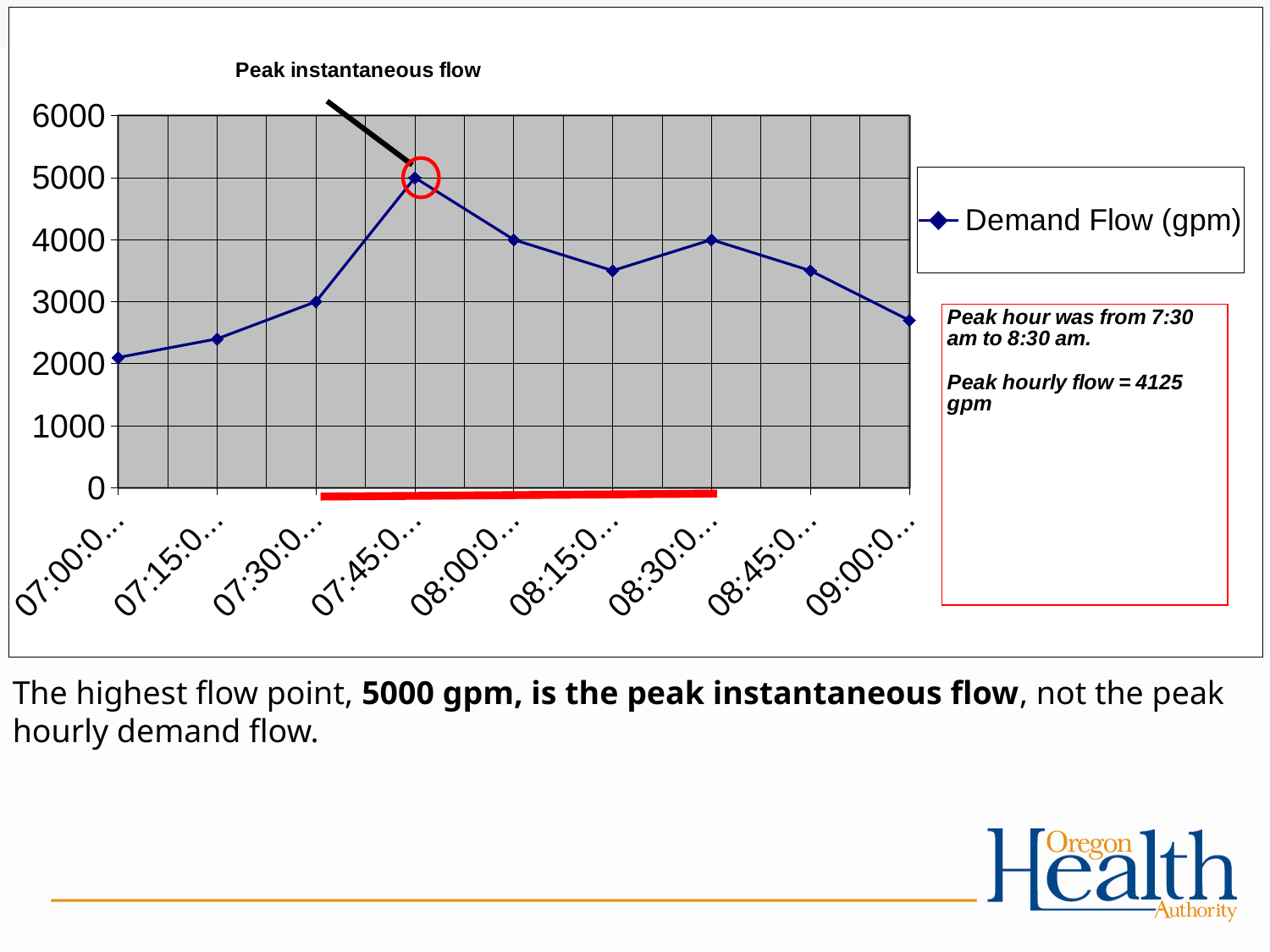
What is the Demand Flow value at 08:00? 4000 What is the Demand Flow value at 07:30? 3000 What is the Demand Flow value at 07:45? 5000 How many series does the legend list? 1 Does the Demand Flow rise or fall from 07:00 to 07:45? rise What type of chart is shown on the slide? line chart At which time does the Demand Flow reach its highest value? 07:45 Is the Demand Flow at 07:00 greater or less than 3000? less How many data points are plotted on the Demand Flow line? 9 What is the difference between the Demand Flow at 07:45 and at 08:00? 1000 What is the name of the series shown in the legend? Demand Flow (gpm) Is the Demand Flow at 08:15 greater or less than 3000? greater